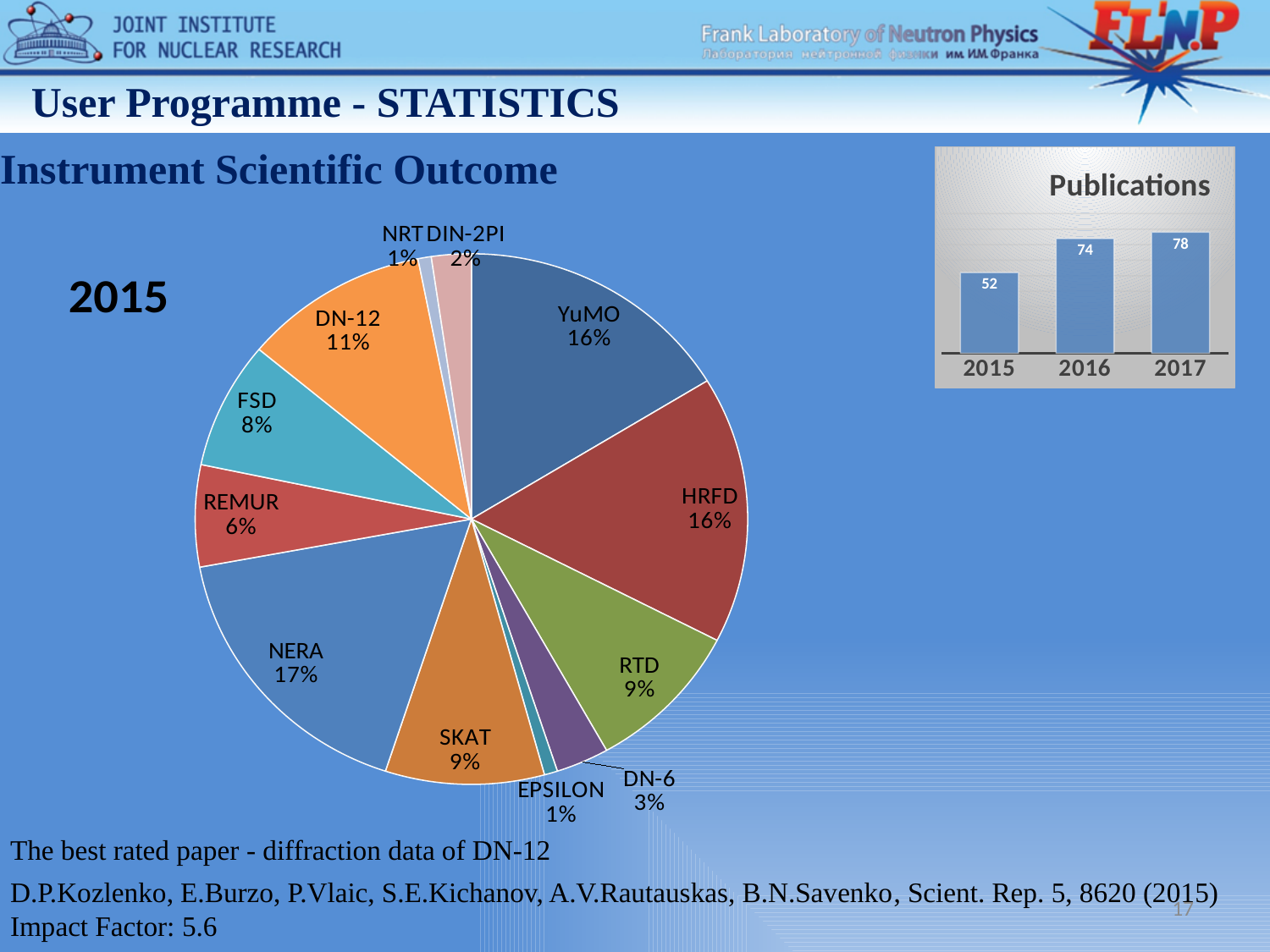
In the 2015 pie chart, what share does DN-12 have? 11% In the 2015 pie chart, which instrument has the largest share? NERA In the Publications bar chart, what is the difference between the 2017 and 2015 values? 26 In the 2015 pie chart, which is larger, the share for FSD or the share for REMUR? FSD In the Publications bar chart, which year has the lowest number of publications? 2015 What kind of chart is the 2015 Instrument Scientific Outcome chart? pie chart What kind of chart is the Publications chart? bar chart In the Publications bar chart, which year has the highest number of publications? 2017 How many slices does the 2015 pie chart have? 12 In the Publications bar chart, how many publications were there in 2016? 74 In the 2015 pie chart, what share does NERA have? 17% In the Publications bar chart, do the values rise or fall from 2015 to 2017? rise